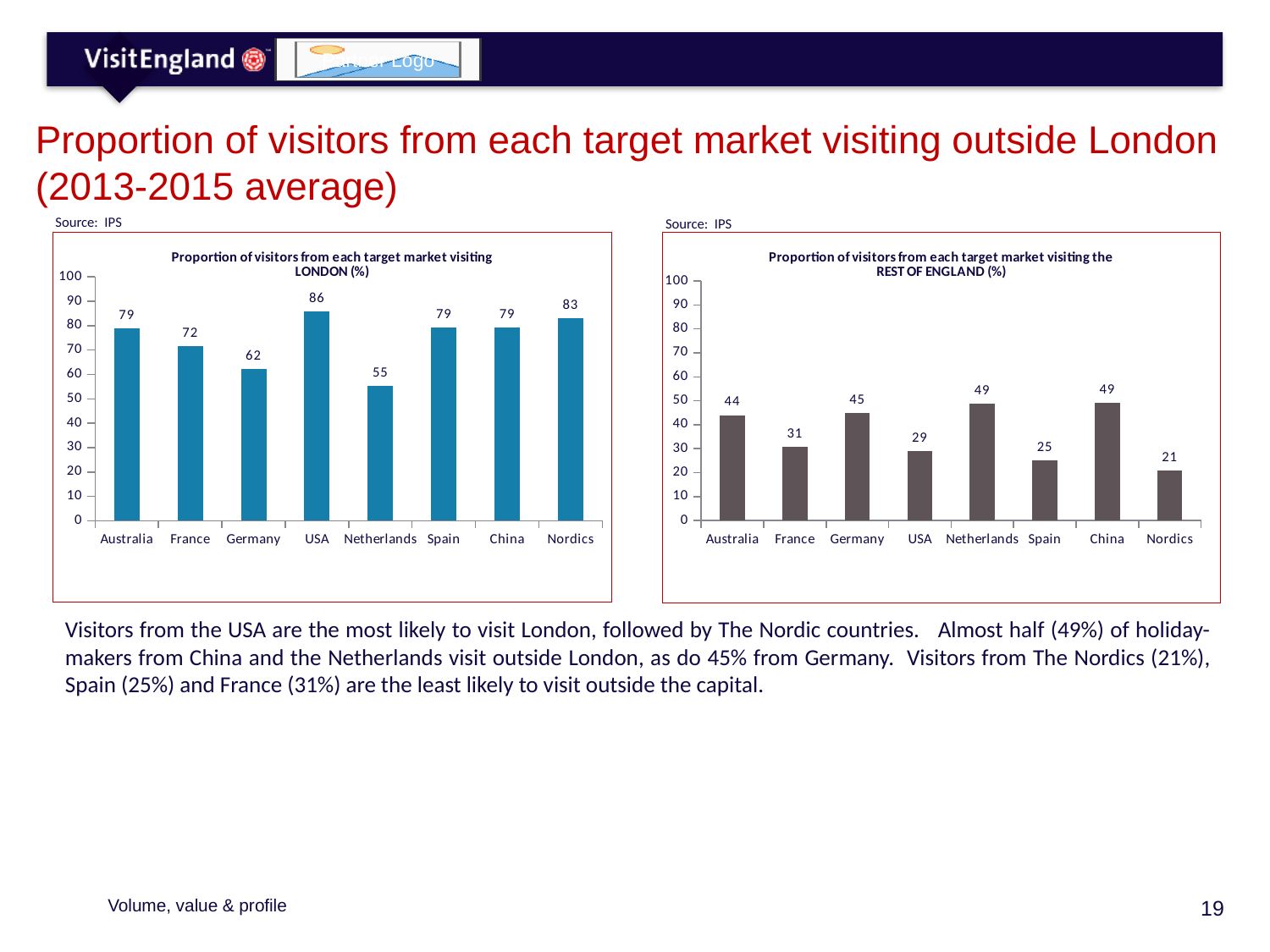
In the right chart (visiting the REST OF ENGLAND), what is the difference between the values for Australia and France? 13 What colour are the bars in the right chart (visiting the REST OF ENGLAND)? dark grey In the left chart (visiting LONDON), which market has the lowest value? Netherlands How many markets are shown on the x axis of the right chart (visiting the REST OF ENGLAND)? 8 In the left chart (visiting LONDON), which market has the highest value? USA In the left chart (visiting LONDON), what is the difference between the values for Nordics and Germany? 21 In the chart titled 'Proportion of visitors from each target market visiting the REST OF ENGLAND (%)', what is the value for Spain? 25 In the right chart (visiting the REST OF ENGLAND), which is larger, the value for Germany or the value for USA? Germany What kind of chart is the left chart (visiting LONDON)? bar chart In the chart titled 'Proportion of visitors from each target market visiting LONDON (%)', what is the value for the USA? 86 In the right chart (visiting the REST OF ENGLAND), which market has the lowest value? Nordics In the left chart (visiting LONDON), is the value for France greater or less than 80? less